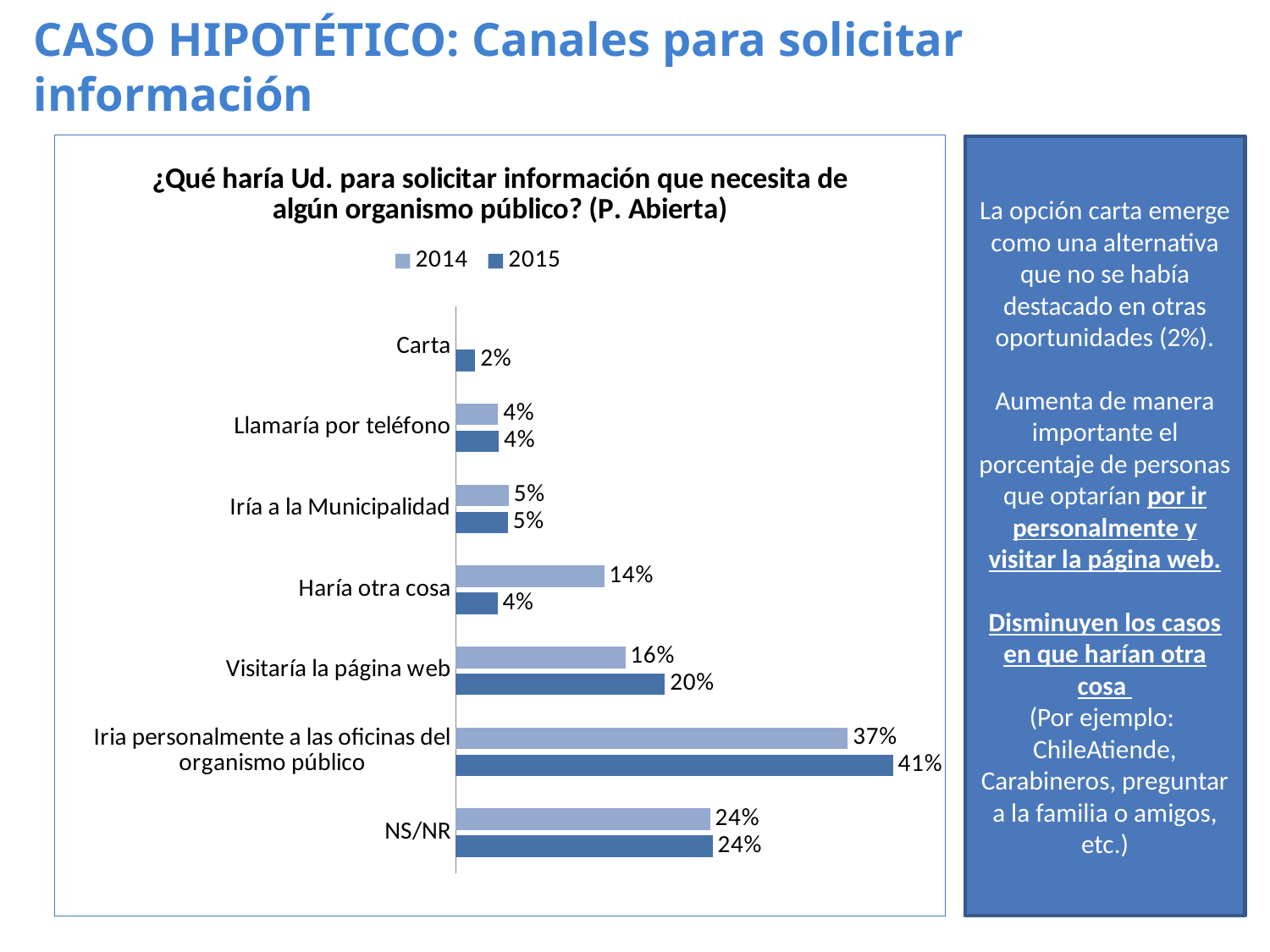
What is the 2014 value for "Haría otra cosa"? 14% What is the 2015 value for "Carta"? 2% What kind of chart is shown on the slide? Bar chart How many categories are shown on the chart? 7 Which category has the lowest 2014 value? Llamaría por teléfono Which is larger for "Iria personalmente a las oficinas del organismo público": the 2014 value or the 2015 value? 2015 What is the 2015 value for "Iria personalmente a las oficinas del organismo público"? 41% How many series does the legend list? 2 What is the difference between the 2014 and 2015 values for "Haría otra cosa"? 10% Which category has the highest 2015 value? Iria personalmente a las oficinas del organismo público What is the 2014 value for "Visitaría la página web"? 16% What is the difference between the 2015 and 2014 values for "Visitaría la página web"? 4%